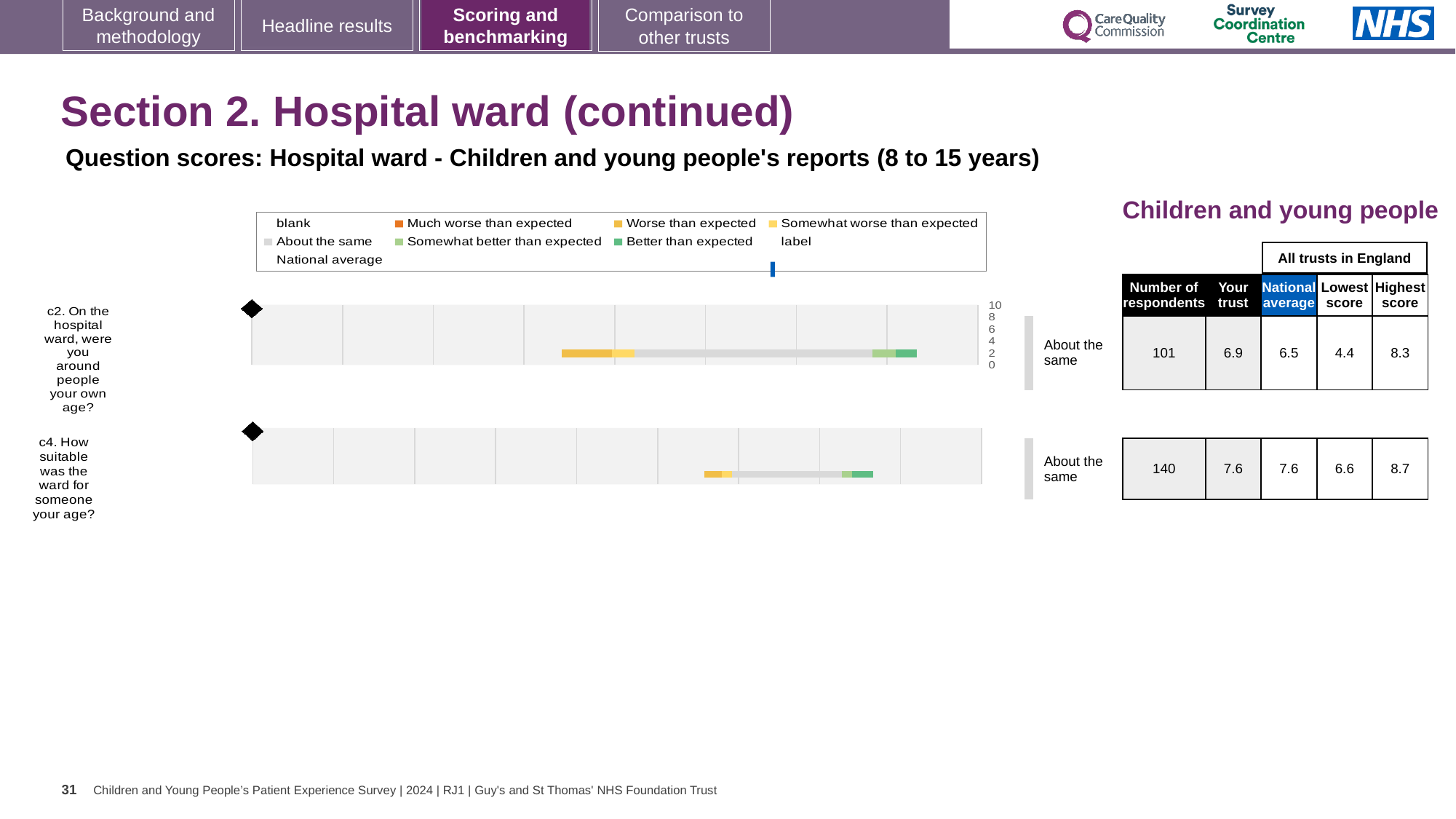
Which question has the higher 'Your trust' score, c2 or c4? c4 What benchmark category is shown for both c2 and c4? About the same How many respondents answered question c2? 101 What is the national average score for c4? 7.6 What kind of chart is used to show the question scores for c2 and c4? bar chart How many questions are plotted on the chart? 2 What is the difference between the highest and lowest scores for c2? 3.9 What is the 'Your trust' score for c4 (How suitable was the ward for someone your age?)? 7.6 What is the 'Your trust' score for c2 (On the hospital ward, were you around people your own age?)? 6.9 By how much does the trust's score for c2 exceed the national average? 0.4 Which legend entry is shown in dark orange? Much worse than expected What is the lowest score among all trusts in England for c4? 6.6